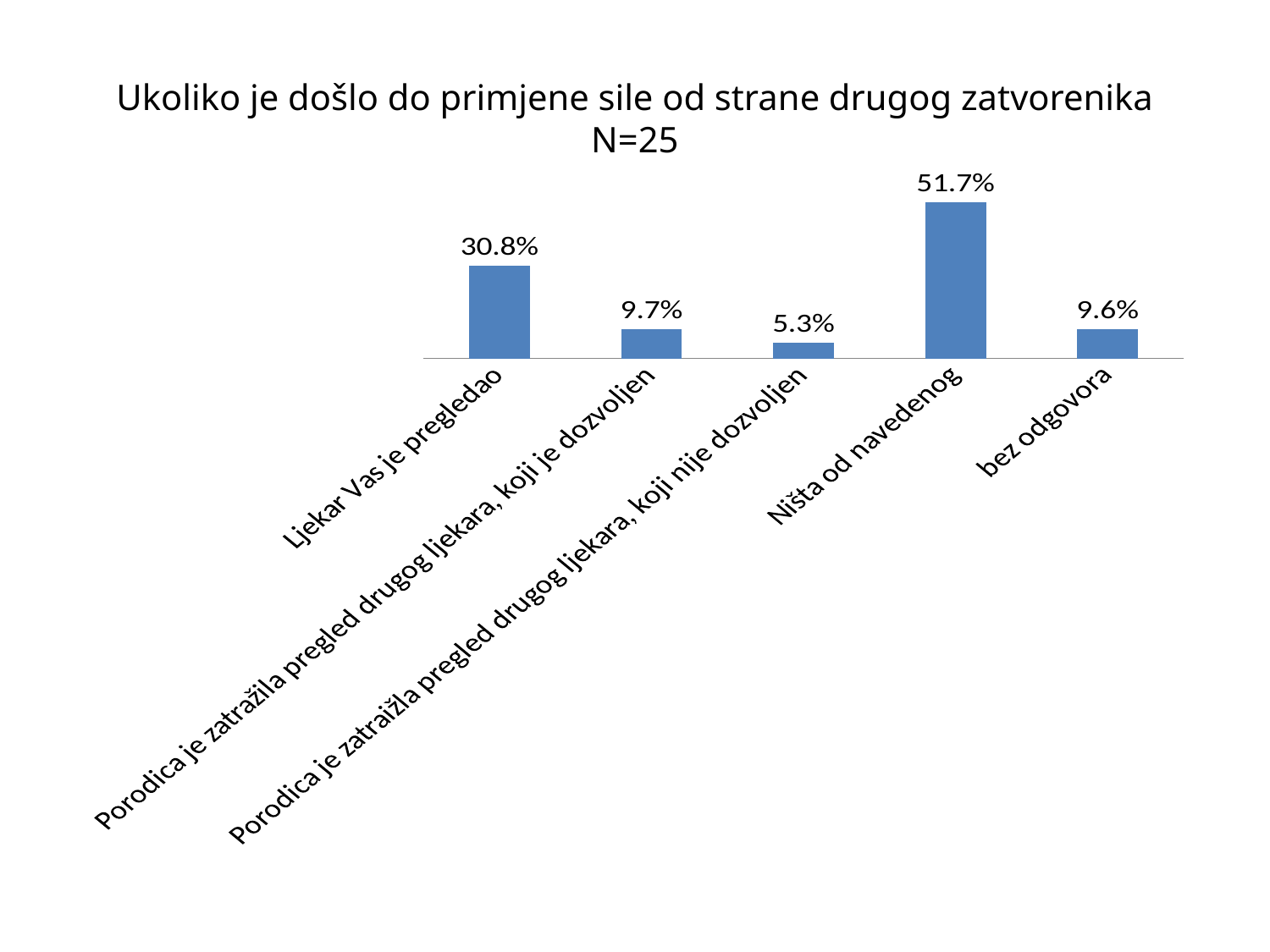
What is the sample size (N) stated in the chart title? N=25 What is the difference between the values for "Porodica je zatražila pregled drugog ljekara, koji je dozvoljen" and "Porodica je zatraižla pregled drugog ljekara, koji nije dozvoljen"? 4.4% What is the value for "bez odgovora"? 9.6% Which is larger: the value for "Ljekar Vas je pregledao" or the value for "bez odgovora"? Ljekar Vas je pregledao Which category has the lowest value? Porodica je zatraižla pregled drugog ljekara, koji nije dozvoljen What is the value for "Ljekar Vas je pregledao"? 30.8% What is the difference between the values for "Ništa od navedenog" and "Ljekar Vas je pregledao"? 20.9% What is the value for "Porodica je zatražila pregled drugog ljekara, koji je dozvoljen"? 9.7% How many categories are shown in the chart? 5 Which category has the highest value? Ništa od navedenog What is the value for "Ništa od navedenog"? 51.7% What kind of chart is shown on the slide? Bar chart